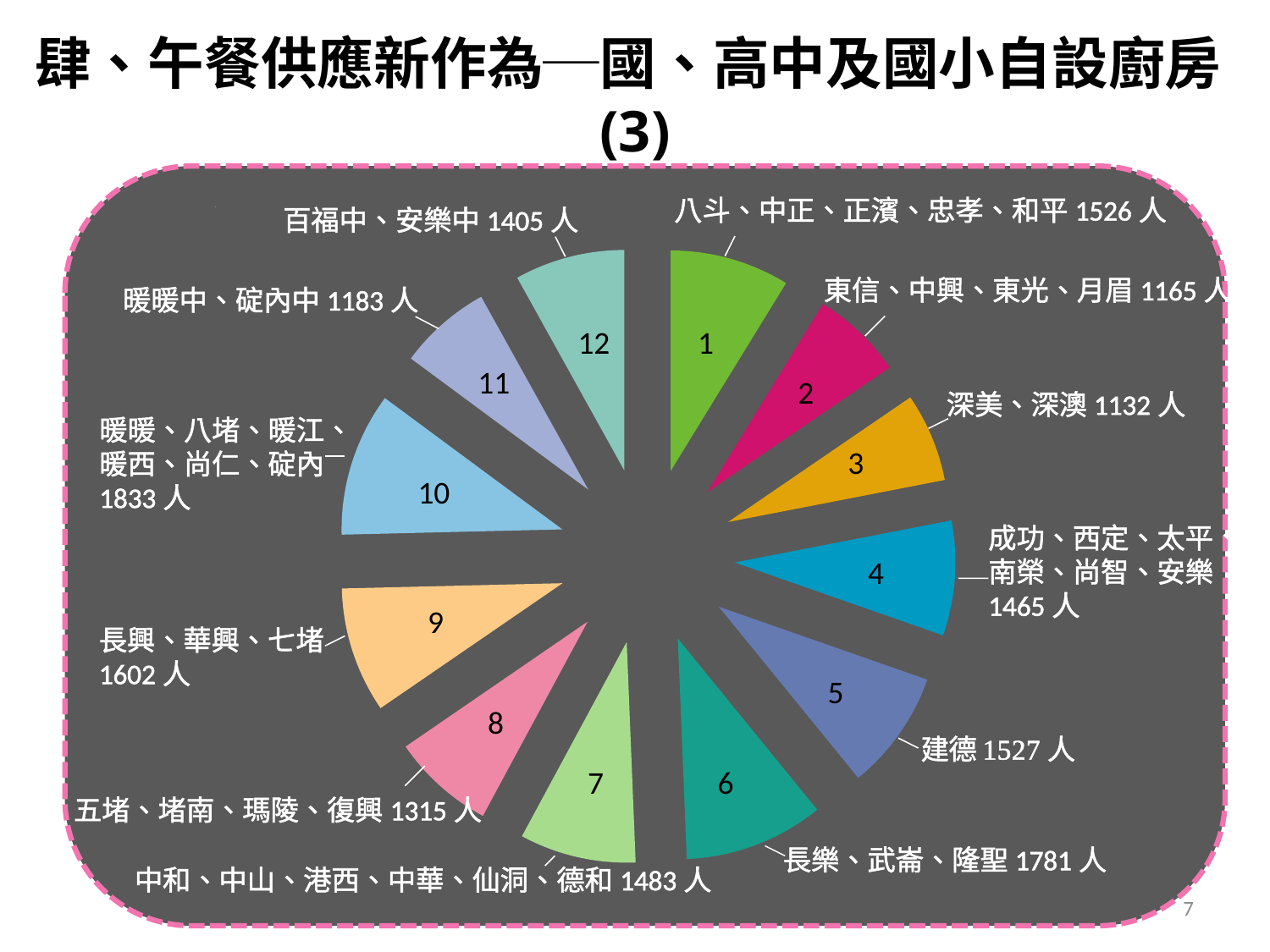
Which has more people: 建德 (slice 5) or 八斗、中正、正濱、忠孝、和平 (slice 1)? 建德 (1527 人) Which slice number is labelled 東信、中興、東光、月眉 1165 人? 2 How many people are listed for slice 3 (深美、深澳)? 1132 人 What kind of chart is shown on the slide? pie chart How many slices does the pie chart have? 12 Which slice has the smallest number of people? 3 (深美、深澳 1132 人) Which slice has the largest number of people? 10 (暖暖、八堵、暖江、暖西、尚仁、碇內 1833 人) How many people are listed for slice 12 (百福中、安樂中)? 1405 人 What is the difference in people between slice 9 (長興、華興、七堵) and slice 8 (五堵、堵南、瑪陵、復興)? 287 人 What is the difference in people between slice 10 (1833 人) and slice 3 (1132 人)? 701 人 How many people are listed for slice 6 (長樂、武崙、隆聖)? 1781 人 How many people are listed for slice 10 (暖暖、八堵、暖江、暖西、尚仁、碇內)? 1833 人